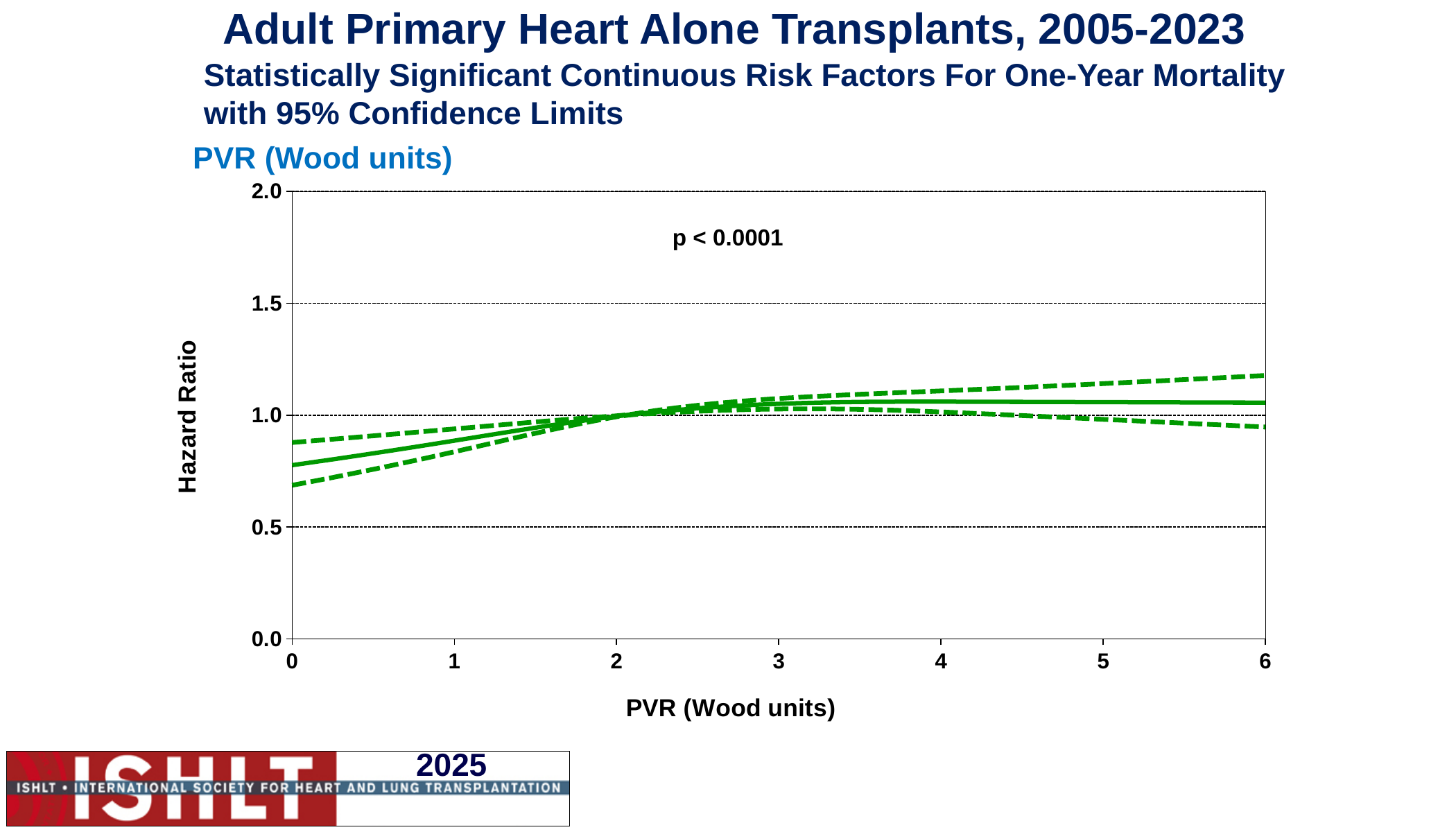
What kind of chart is shown on the slide? line chart Is the upper dashed confidence limit at PVR 6 Wood units greater or less than 1.0? greater Is the hazard ratio (solid line) at PVR 0 Wood units greater or less than 1.0? less What is the highest value shown on the y axis? 2.0 Is the lower dashed confidence limit at PVR 0 Wood units greater or less than 0.5? greater Which is larger: the hazard ratio (solid line) at PVR 0 Wood units or at PVR 4 Wood units? PVR 4 Wood units How many lines are plotted on the chart? 3 Between PVR 0 and PVR 2 Wood units, does the solid hazard ratio line rise or fall? rise What is the label of the y axis? Hazard Ratio What is the label of the x axis? PVR (Wood units)